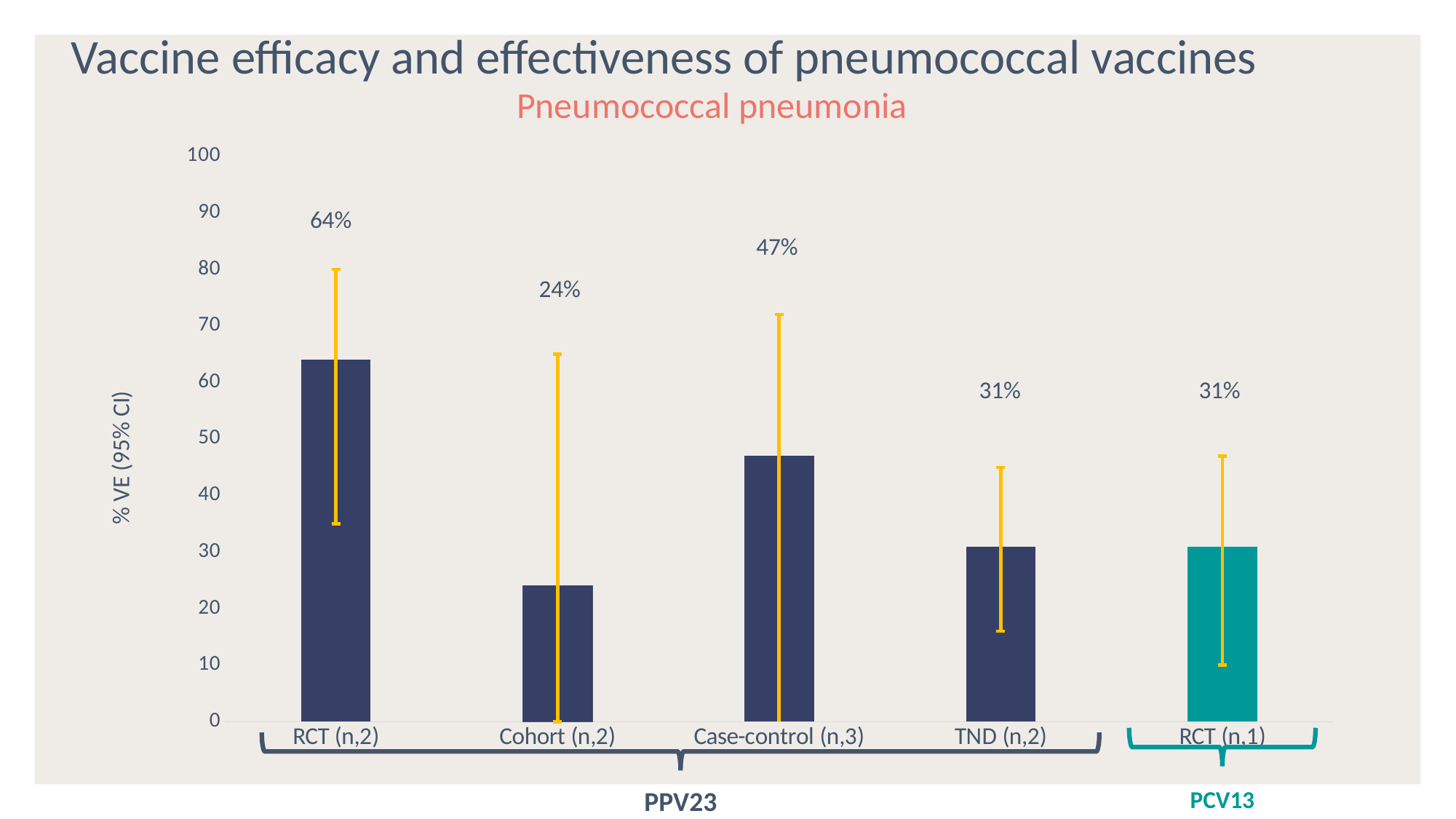
What is the vaccine effectiveness value for RCT (n,2) under PPV23? 64% Which is larger, the value for Case-control (n,3) or the value for TND (n,2)? Case-control (n,3) What is the vaccine effectiveness value for Cohort (n,2)? 24% What is the subtitle shown in red below the main chart title? Pneumococcal pneumonia How many bars are shown in the chart? 5 What is the vaccine effectiveness value for Case-control (n,3)? 47% Which study design has the lowest vaccine effectiveness value? Cohort (n,2) What is the difference between the values for RCT (n,2) and Case-control (n,3)? 17% What is the vaccine effectiveness value for RCT (n,1) under PCV13? 31% Which study design has the highest vaccine effectiveness value? RCT (n,2) What kind of chart is shown on the slide? Bar chart What is the label of the y axis? % VE (95% CI)